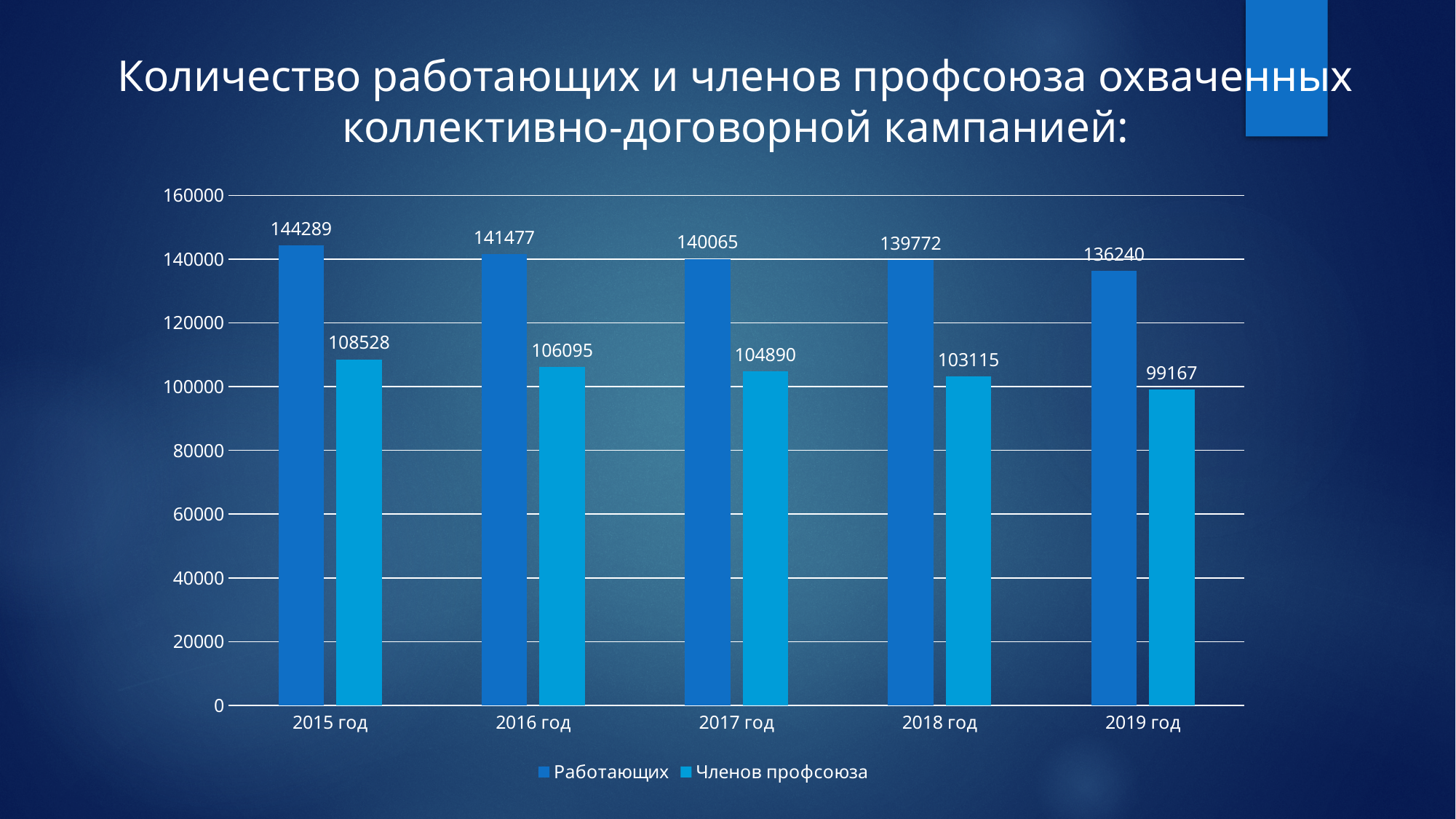
What is the difference between Работающих and Членов профсоюза in 2018 год? 36657 What kind of chart is shown on the slide? bar chart What is the value for Членов профсоюза in 2019 год? 99167 What is the value for Членов профсоюза in 2017 год? 104890 Do the values for Членов профсоюза rise or fall from 2015 год to 2019 год? fall Which year has the highest value for Работающих? 2015 год How many series does the legend list? 2 How many years are shown on the x axis? 5 Which is larger: Членов профсоюза in 2016 год or Членов профсоюза in 2019 год? 2016 год Is the value for Работающих in 2019 год greater or less than 140000? less Which year has the lowest value for Членов профсоюза? 2019 год What is the value for Работающих in 2015 год? 144289